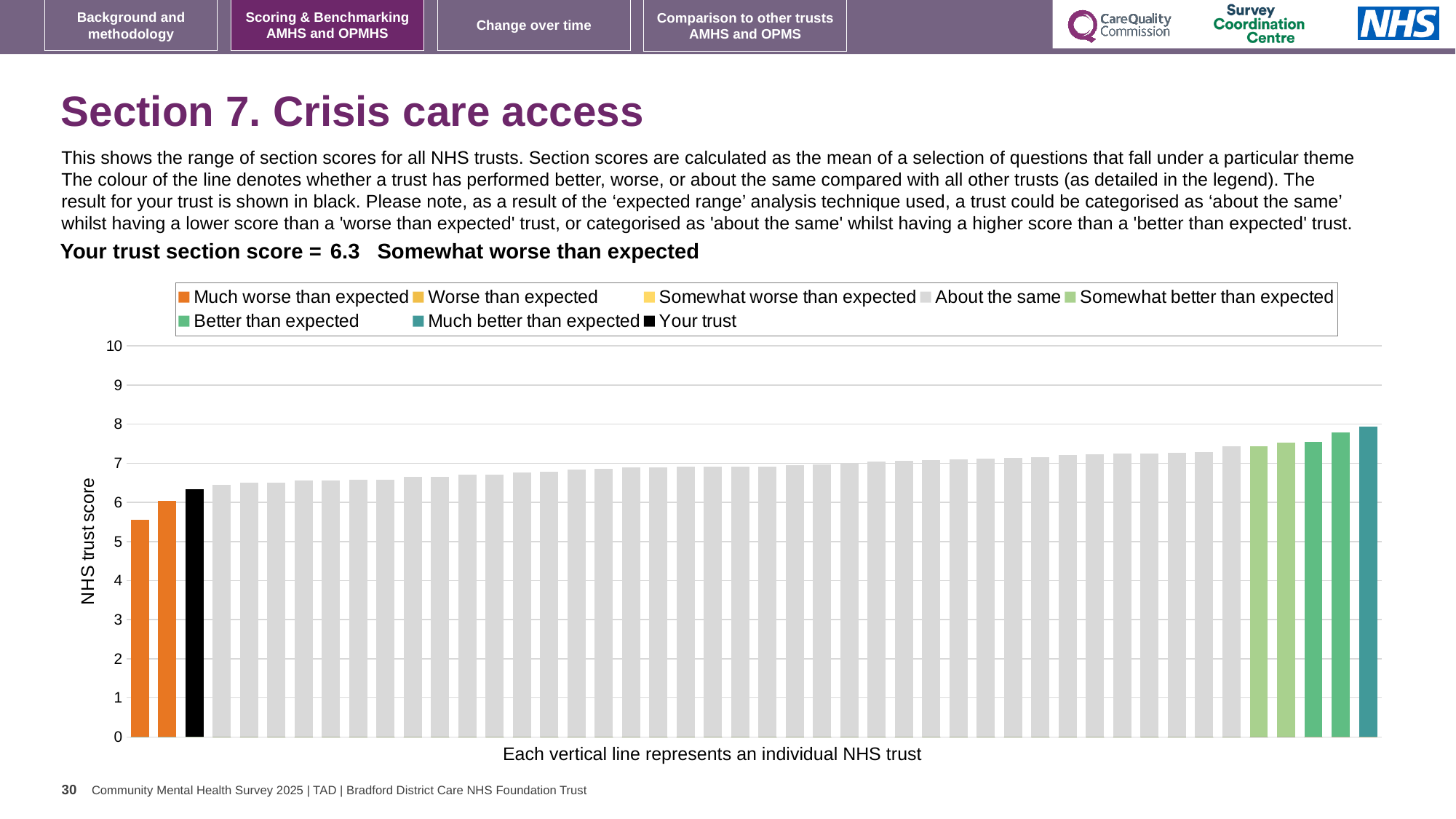
Which is larger: the value for your trust (black bar) or the value of the leftmost orange bar? your trust What is the label on the vertical axis of the chart? NHS trust score Is the value of the lowest bar on the chart greater or less than 6? less Is the value for your trust (the black bar) greater or less than 5? greater Which performance category does your trust fall into for crisis care access? Somewhat worse than expected Is the value of the highest bar on the chart greater or less than 7? greater How many bars are coloured as 'Much worse than expected'? 2 What kind of chart is shown on the slide? bar chart How many bars are coloured as 'Much better than expected'? 1 What is the section score for your trust shown on the slide? 6.3 Do the bar values rise or fall from left to right along the x axis? rise How many entries does the chart legend list? 8